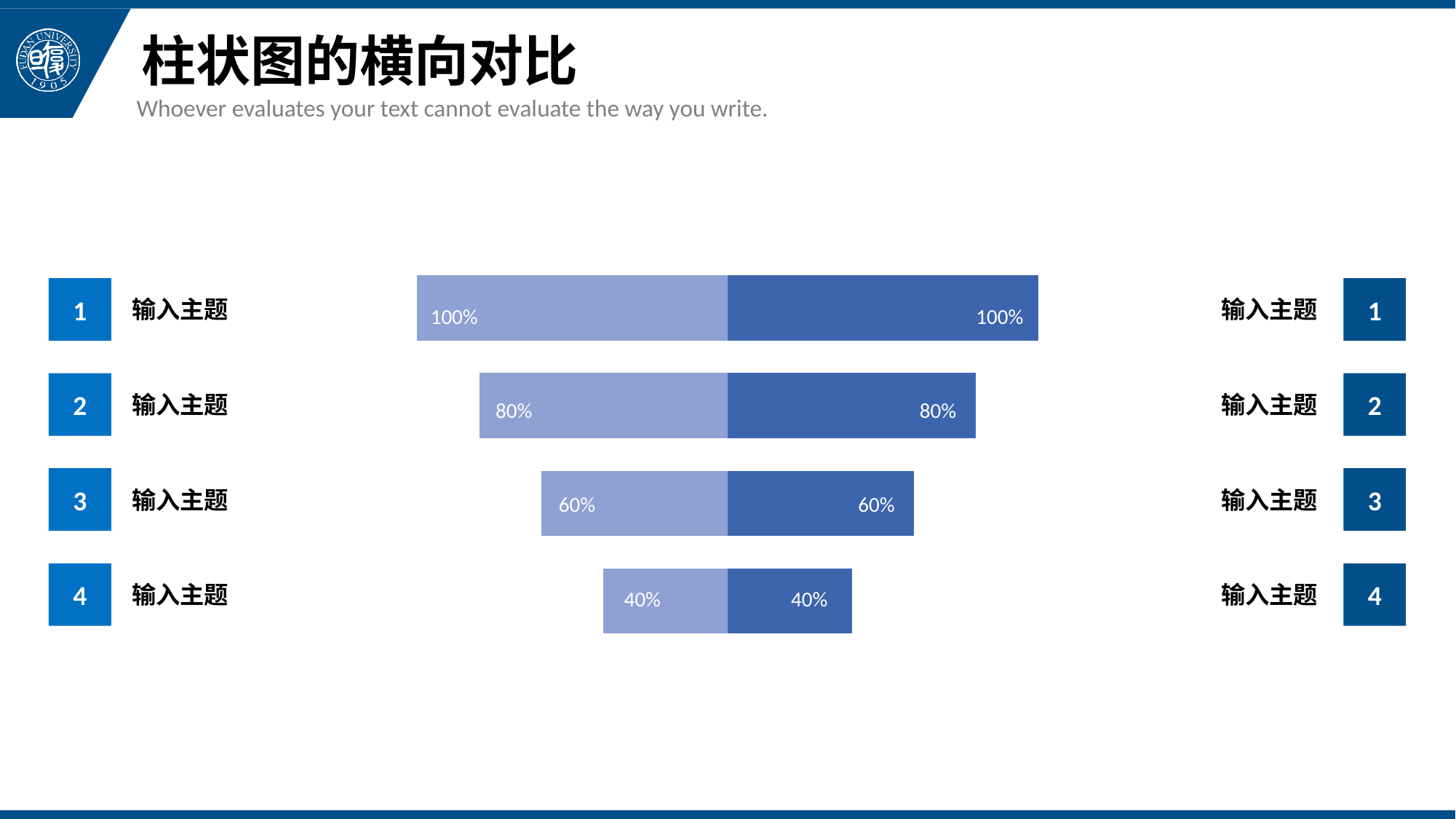
Which row has the highest value? Row 1 Which row has the lowest value? Row 4 What is the value of the dark blue bar in row 4? 40% What is the value of the light blue bar in row 3? 60% Do the values rise or fall going from row 1 down to row 4? fall What is the value of the light blue bar in row 1? 100% What is the value of the dark blue bar in row 2? 80% How many rows (categories) does the bar chart have? 4 What is the difference between the value in row 1 and the value in row 4? 60% What is the title of the slide containing the chart? 柱状图的横向对比 Which is larger, the value in row 2 or the value in row 3? Row 2 What kind of chart is shown on the slide? bar chart